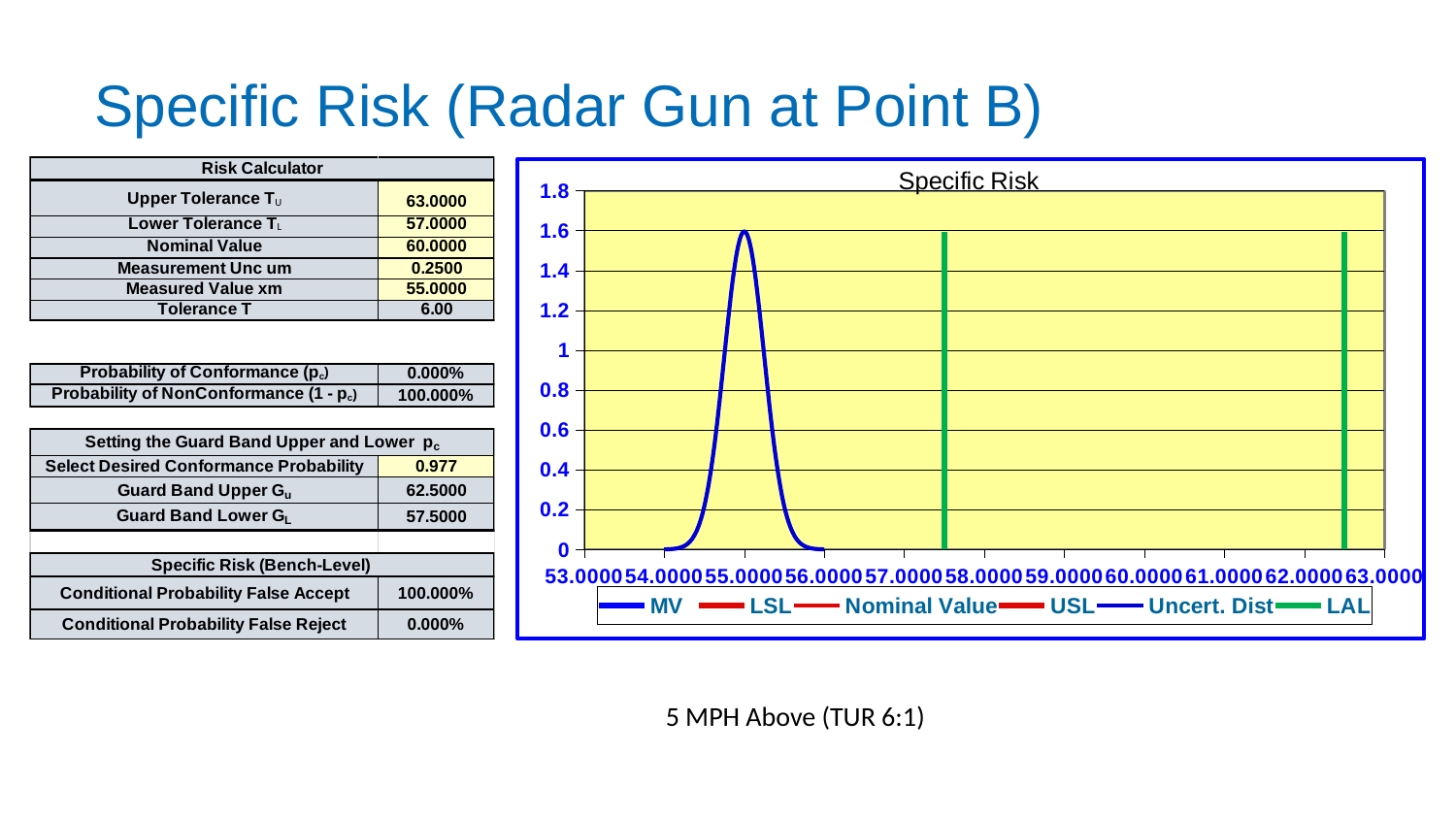
What is the highest value shown on the chart's y axis? 1.8 What kind of chart is shown on the slide? line chart At which x-axis value does the blue bell-shaped curve reach its peak? 55.000 What is the title of the chart on the slide? Specific Risk Is the peak of the blue bell-shaped curve greater or less than 1.8 on the y axis? less What is the highest value shown on the chart's x axis? 63.000 Does the blue curve rise or fall as the x axis moves from 55.000 to 56.000? fall Is the peak of the blue bell-shaped curve greater or less than 1.4 on the y axis? greater Is the right green vertical line positioned at an x value greater or less than 63.000? less How many series does the chart's legend list? 6 What is the lowest value shown on the chart's x axis? 53.000